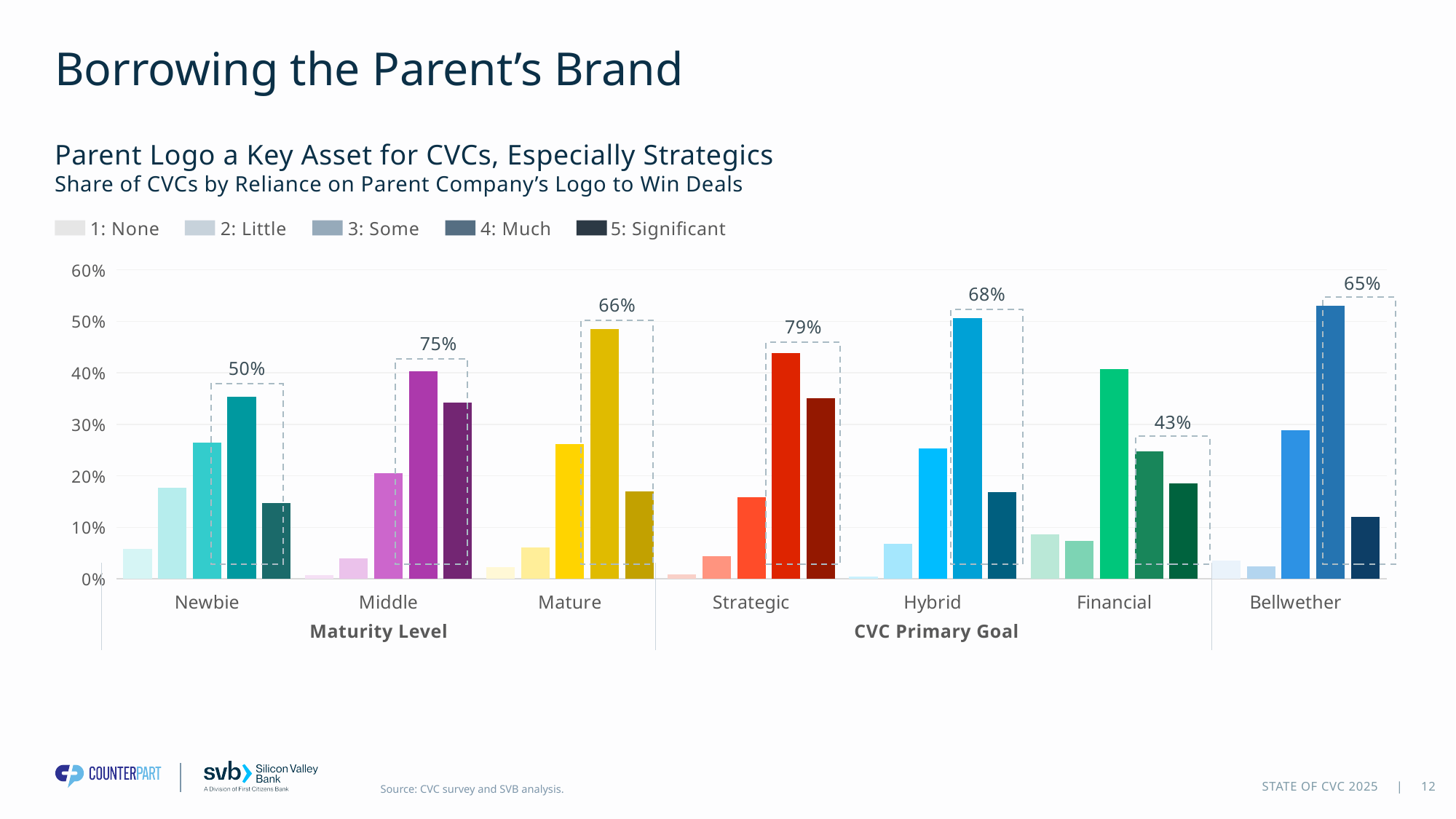
Which has the larger labelled combined share: Middle or Bellwether? Middle Which category has the highest labelled combined share of Much and Significant? Strategic How many categories are shown along the x axis of the chart? 7 Which category has the lowest labelled combined share of Much and Significant? Financial Is the value of the '5: Significant' bar for Bellwether greater or less than 20%? less What kind of chart is shown on the slide? Bar chart What combined share is labelled above the dashed box (4: Much plus 5: Significant) for the Strategic category? 79% How many series does the legend list? 5 Is the value of the '4: Much' bar for Hybrid greater or less than 40%? greater What are the two group headings shown beneath the x-axis categories? Maturity Level and CVC Primary Goal What is the difference between the labelled combined shares for Strategic (79%) and Financial (43%)? 36 percentage points What combined share is labelled above the dashed box for the Newbie category? 50%